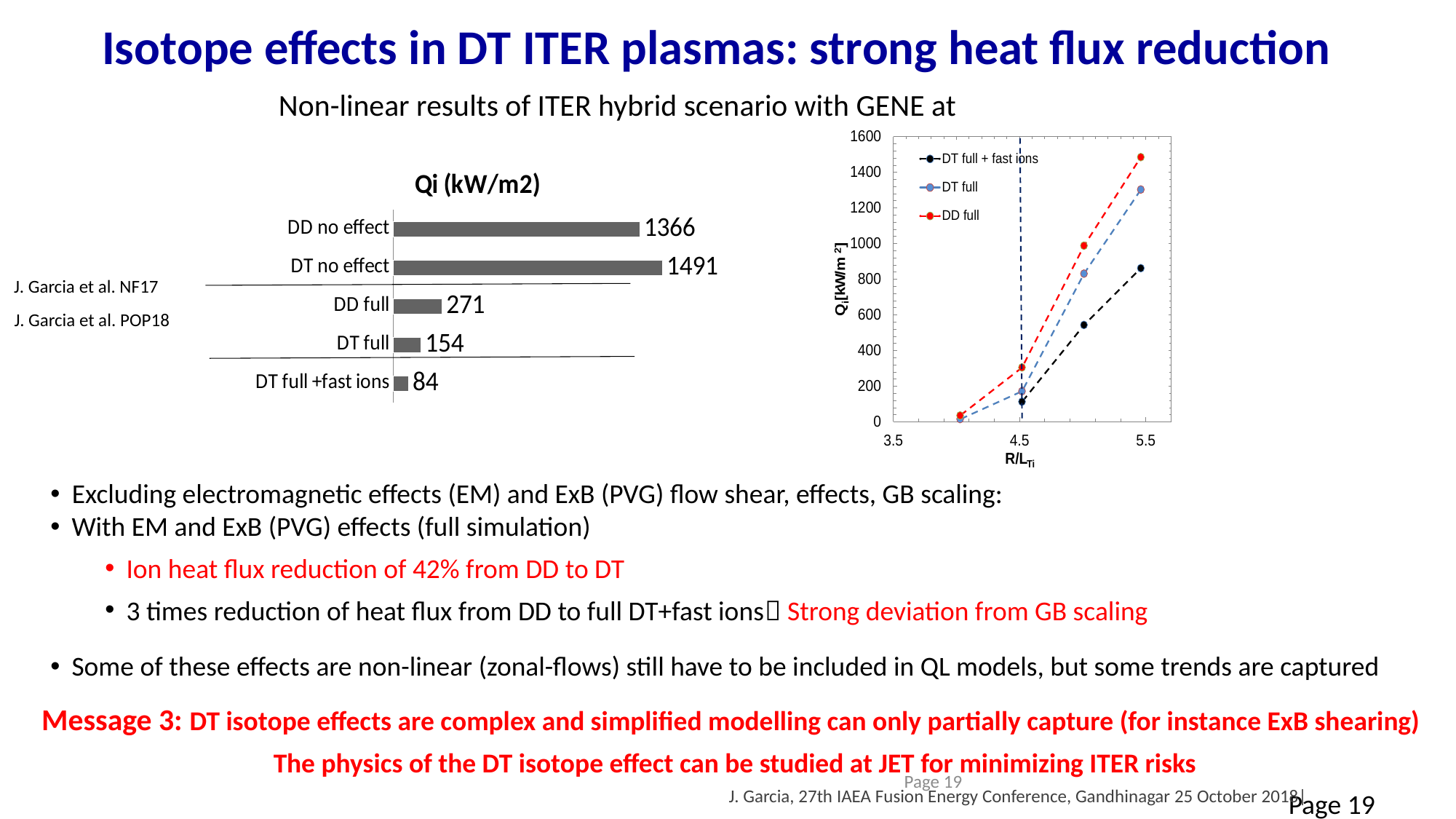
How many series does the legend of the line chart on the right list? 3 In the line chart on the right, is the value of DD full at R/LTi = 5.5 greater or less than 1400? greater In the bar chart titled Qi (kW/m2), what is the value for DT no effect? 1491 How many categories does the bar chart titled Qi (kW/m2) show? 5 In the bar chart titled Qi (kW/m2), what is the value for DD full? 271 In the bar chart titled Qi (kW/m2), which category has the highest value? DT no effect What kind of chart is the chart on the left of the slide? bar chart In the bar chart titled Qi (kW/m2), what is the value for DT full +fast ions? 84 In the bar chart titled Qi (kW/m2), which category has the lowest value? DT full +fast ions In the line chart on the right, do the values of DT full + fast ions rise or fall as R/LTi increases? rise In the bar chart titled Qi (kW/m2), what is the difference between DD full and DT full? 117 In the bar chart titled Qi (kW/m2), which is larger, DD no effect or DT no effect? DT no effect